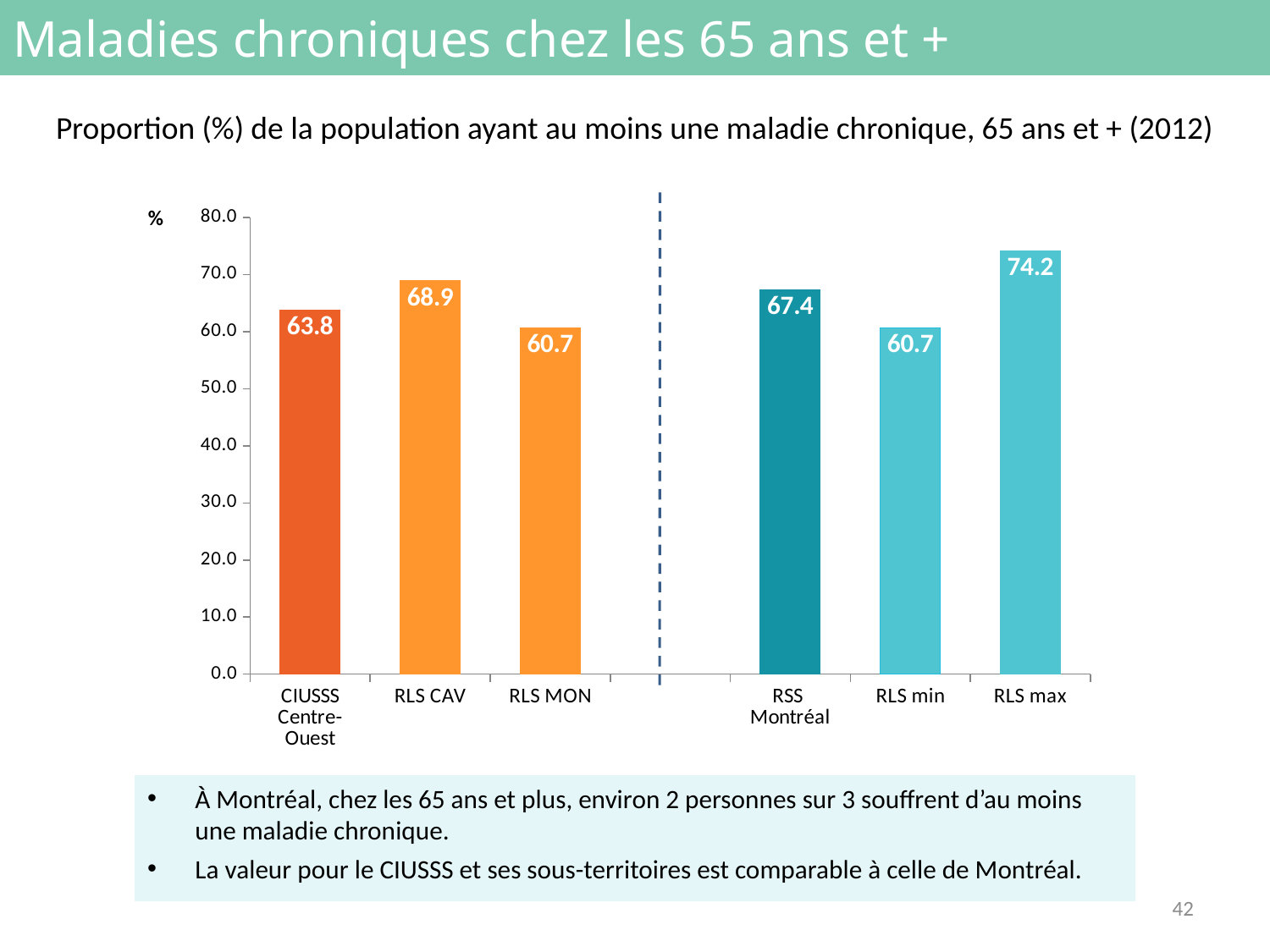
Is the value for RLS MON greater or less than 70.0? less What is the title of the chart? Proportion (%) de la population ayant au moins une maladie chronique, 65 ans et + (2012) What is the value for RSS Montréal? 67.4 What is the difference between the values for RLS CAV and RLS MON? 8.2 Which is larger, the value for RLS CAV or the value for RSS Montréal? RLS CAV What kind of chart is shown on the slide? bar chart How many categories are shown on the x axis? 6 Which category has the highest value? RLS max What is the value for RLS max? 74.2 What is the value for CIUSSS Centre-Ouest? 63.8 What is the value for RLS CAV? 68.9 What is the difference between the values for RLS max and RSS Montréal? 6.8